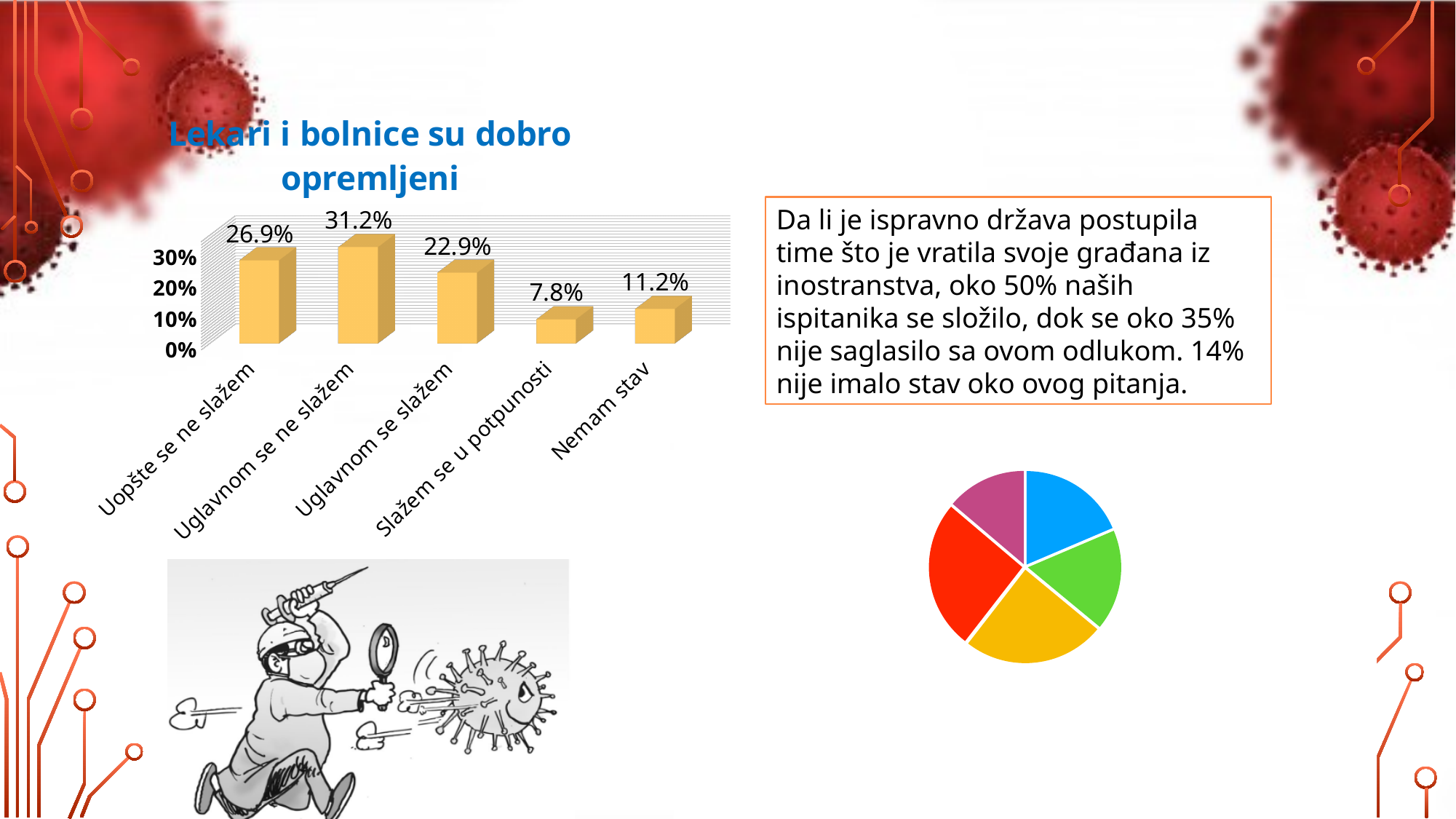
In the chart titled "Lekari i bolnice su dobro opremljeni", what is the value for "Nemam stav"? 11.2% What kind of chart is the chart titled "Lekari i bolnice su dobro opremljeni"? bar chart In the chart titled "Lekari i bolnice su dobro opremljeni", which category has the lowest value? Slažem se u potpunosti In the chart titled "Lekari i bolnice su dobro opremljeni", what is the difference between the values for "Uglavnom se ne slažem" and "Uopšte se ne slažem"? 4.3% In the chart titled "Lekari i bolnice su dobro opremljeni", what is the value for "Uglavnom se ne slažem"? 31.2% In the chart titled "Lekari i bolnice su dobro opremljeni", is the value for "Uopšte se ne slažem" greater or less than 20%? greater In the chart titled "Lekari i bolnice su dobro opremljeni", which category has the highest value? Uglavnom se ne slažem How many slices does the pie chart in the lower right of the slide have? 5 In the chart titled "Lekari i bolnice su dobro opremljeni", what is the value for "Slažem se u potpunosti"? 7.8% In the chart titled "Lekari i bolnice su dobro opremljeni", which is larger: the value for "Uglavnom se slažem" or the value for "Nemam stav"? Uglavnom se slažem How many categories are shown in the chart titled "Lekari i bolnice su dobro opremljeni"? 5 What kind of chart is shown in the lower right of the slide? pie chart